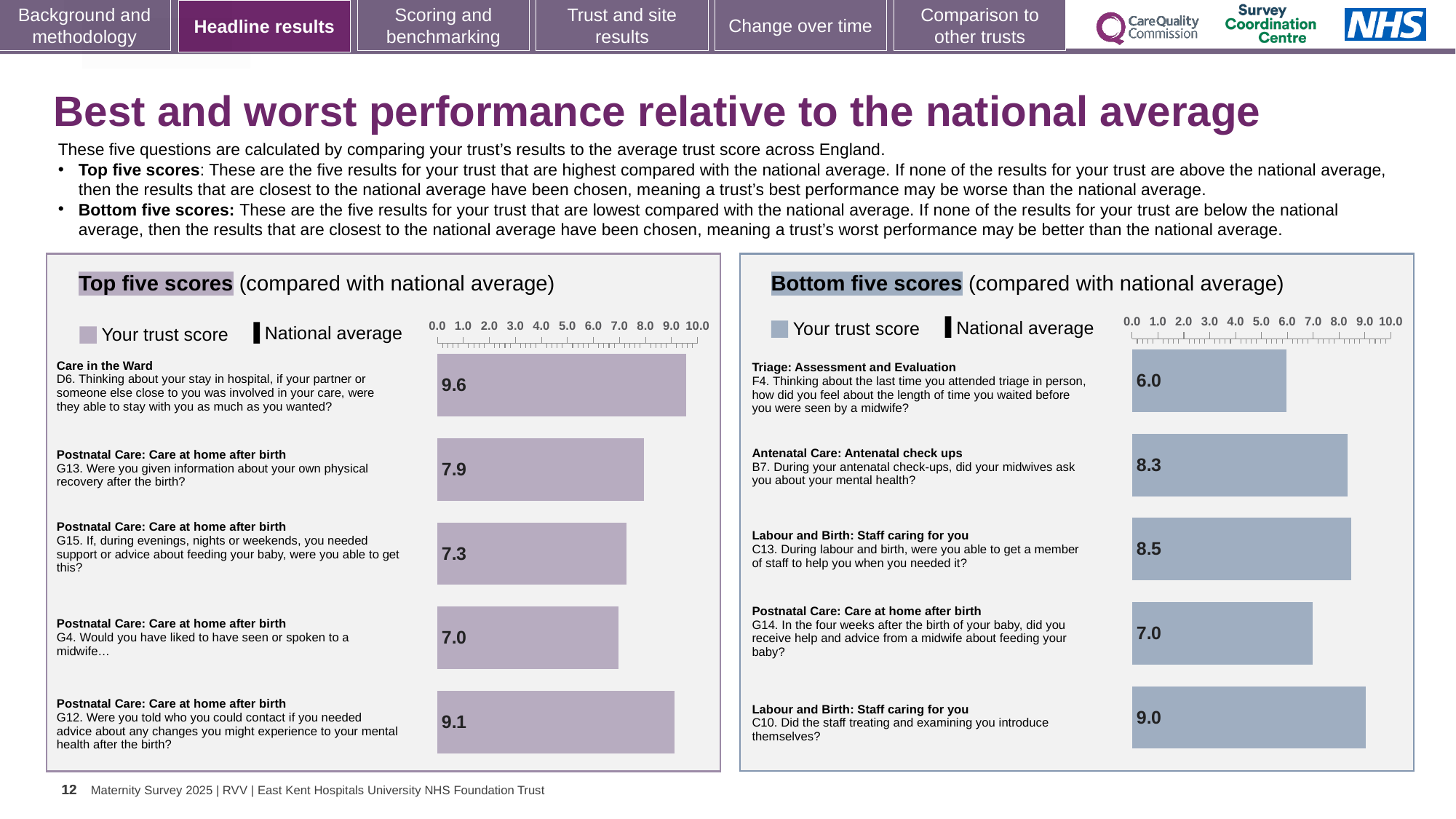
What type of chart is used in the Bottom five scores panel? Bar chart In the Top five scores chart, which question has the highest trust score? D6 (Care in the Ward), 9.6 In the Top five scores chart, what is the trust score for D6 (Care in the Ward)? 9.6 In the Top five scores chart, what is the trust score for G12? 9.1 In the Bottom five scores chart, what is the difference between the scores for C10 and G14? 2.0 In the Top five scores chart, what is the difference between the scores for D6 and G4? 2.6 In the Bottom five scores chart, which has the larger score, C13 or B7? C13 (8.5) In the Bottom five scores chart, what is the trust score for F4 (Triage: Assessment and Evaluation)? 6.0 In the Bottom five scores chart, which question has the lowest trust score? F4 (Triage: Assessment and Evaluation), 6.0 How many bars are shown in the Top five scores chart? 5 In the Bottom five scores chart, which question has the highest trust score? C10 (Labour and Birth: Staff caring for you), 9.0 How many entries does the legend of the Top five scores chart list? 2